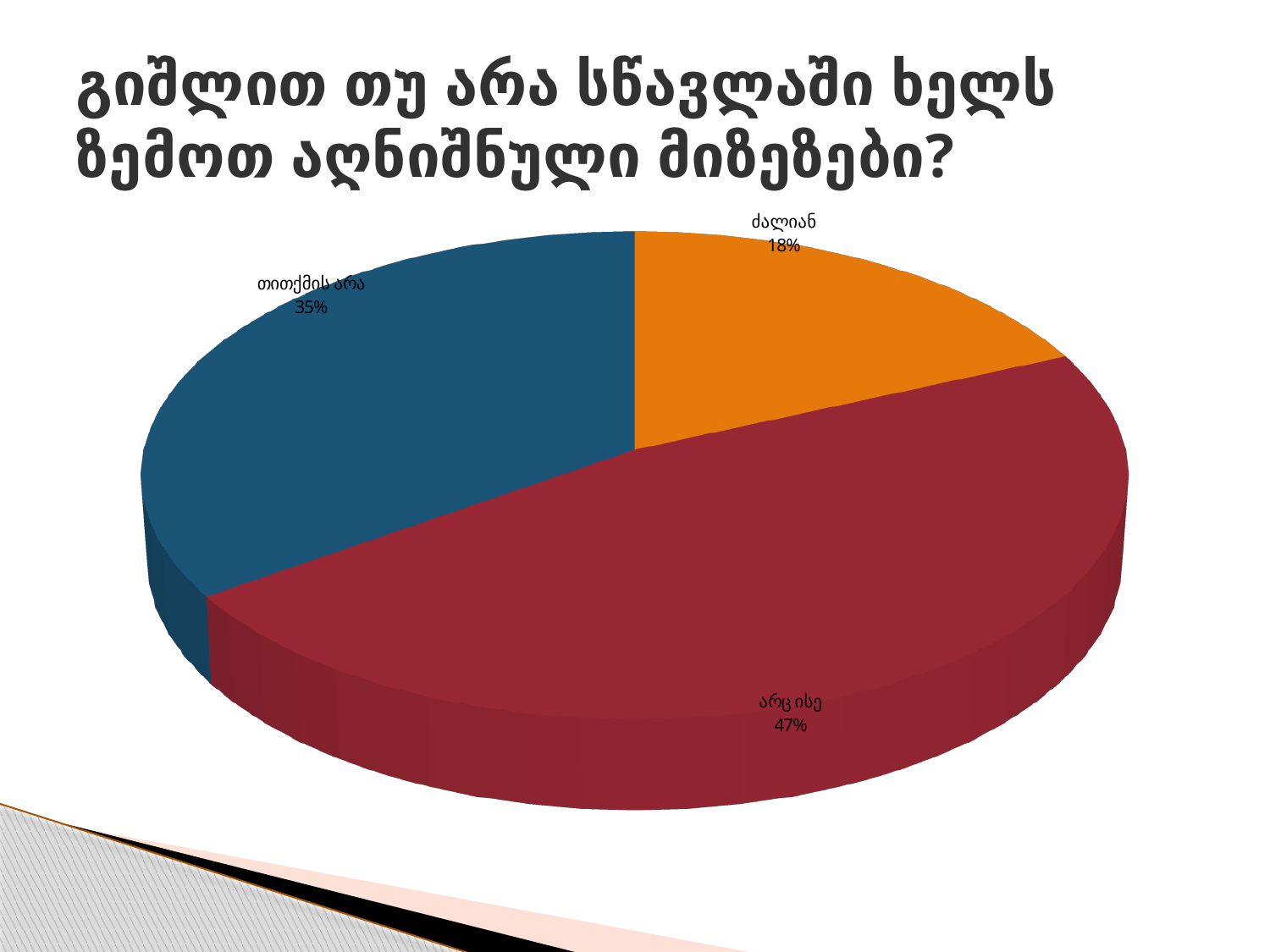
How many slices does the pie chart have? 3 What percentage is shown for the slice labelled არც ისე? 47% Which is larger, the slice for თითქმის არა or the slice for ძალიან? თითქმის არა What percentage is shown for the slice labelled ძალიან? 18% What colour is the slice labelled ძალიან? orange What colour is the slice labelled არც ისე? red What percentage is shown for the slice labelled თითქმის არა? 35% Which slice of the pie chart is the largest? არც ისე What is the difference in percentage points between the თითქმის არა slice and the ძალიან slice? 17 What is the difference in percentage points between the არც ისე slice and the თითქმის არა slice? 12 What kind of chart is shown on the slide? pie chart Which slice of the pie chart is the smallest? ძალიან